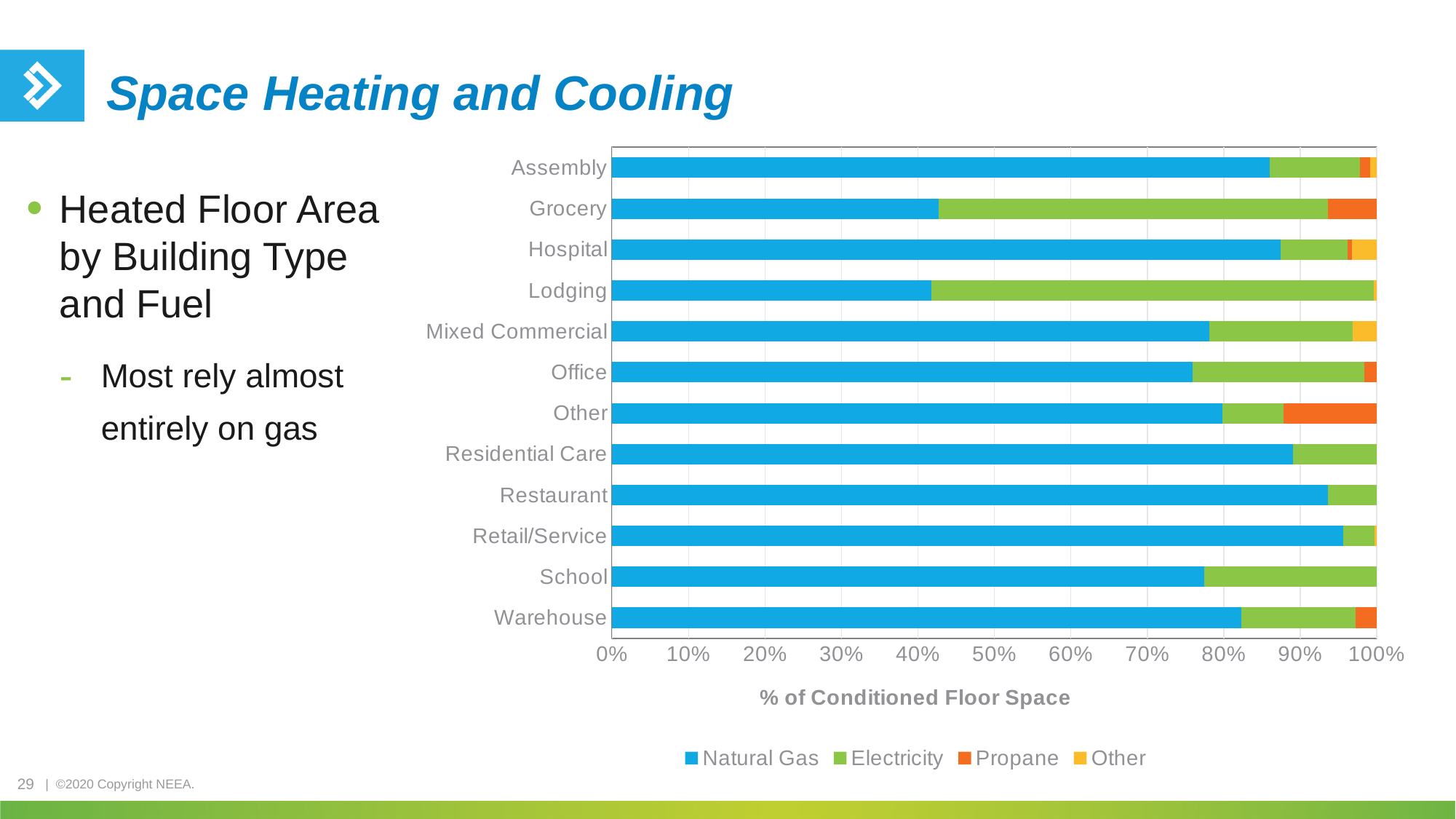
Which building type has the largest Propane share? Other How many series does the chart legend list? 4 Which fuel is shown in orange in the chart legend? Propane Which has the larger Natural Gas share, Grocery or Office? Office Which building type has the largest Electricity share? Lodging Is the Natural Gas share for Office greater or less than 80%? less What kind of chart is shown on the slide? Stacked bar chart Is the Natural Gas share for Retail/Service greater or less than 90%? greater What is the title of the chart's horizontal axis? % of Conditioned Floor Space Is the Natural Gas share for Grocery greater or less than 50%? less How many building types are listed on the chart's vertical axis? 12